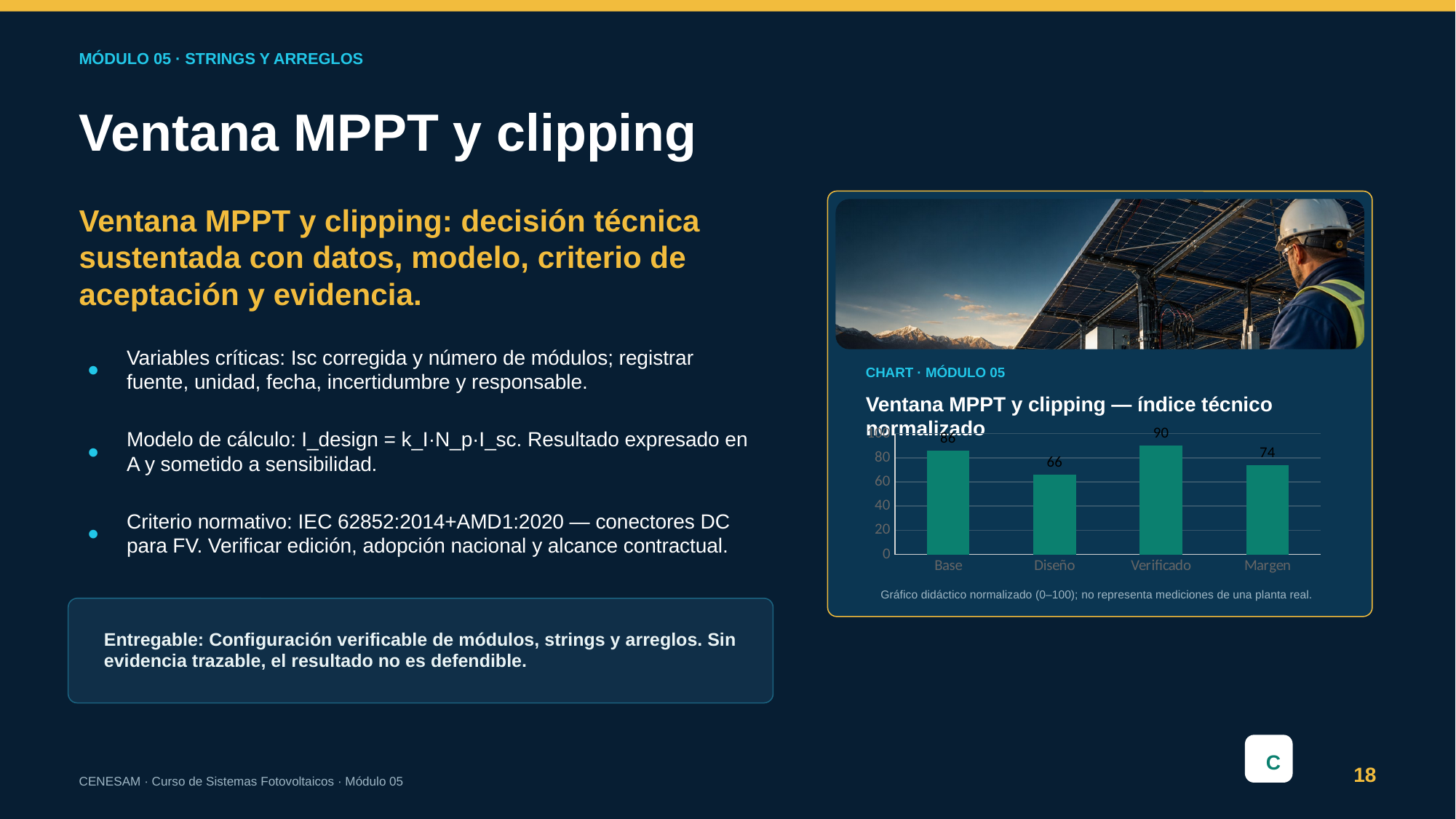
What type of chart is shown on the slide? bar chart Which category has the highest value in the chart? Verificado What is the title of the chart? Ventana MPPT y clipping — índice técnico normalizado What is the difference between the values for Verificado and Diseño? 24 What is the value for Diseño in the chart? 66 What is the value for Verificado in the chart? 90 How many categories are shown on the x axis of the chart? 4 What is the value for Margen in the chart? 74 Is the value for Margen greater or less than 80? less What is the value for Base in the chart? 86 Which is larger, the value for Margen or the value for Diseño? Margen Which category has the lowest value in the chart? Diseño